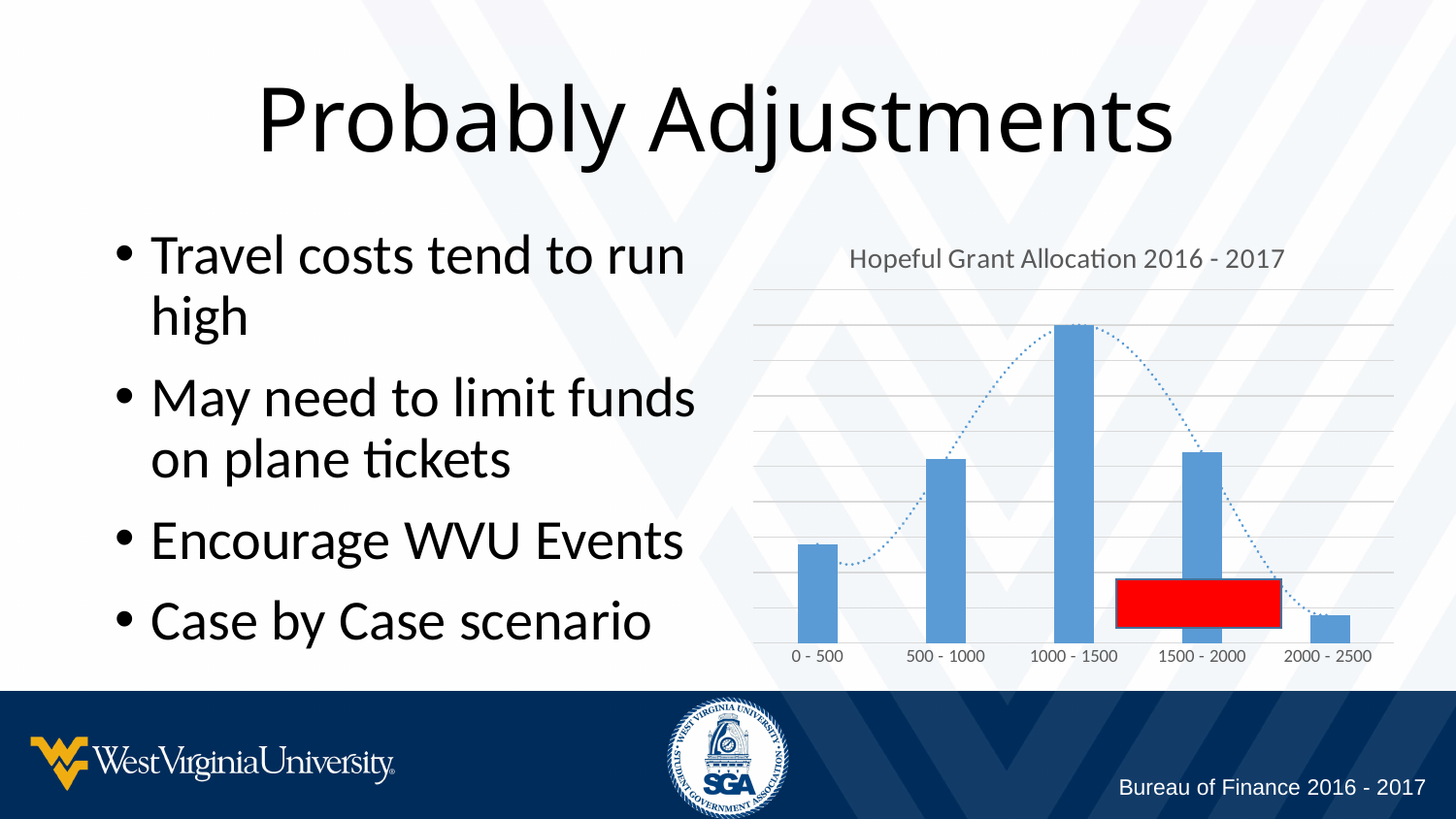
What is the title of the chart on the slide? Hopeful Grant Allocation 2016 - 2017 Do the bar values rise or fall from 1000 - 1500 to 2000 - 2500? fall Do the bar values rise or fall from 0 - 500 to 1000 - 1500? rise Which category has the lowest bar in the chart? 2000 - 2500 Which category has the highest bar in the chart? 1000 - 1500 What kind of chart is shown on the slide? bar chart Which has the larger value, 1000 - 1500 or 1500 - 2000? 1000 - 1500 How many categories are shown on the x axis of the chart? 5 Which has the larger value, 0 - 500 or 500 - 1000? 500 - 1000 What is the label of the first category on the x axis of the chart? 0 - 500 Which has the larger value, 0 - 500 or 2000 - 2500? 0 - 500